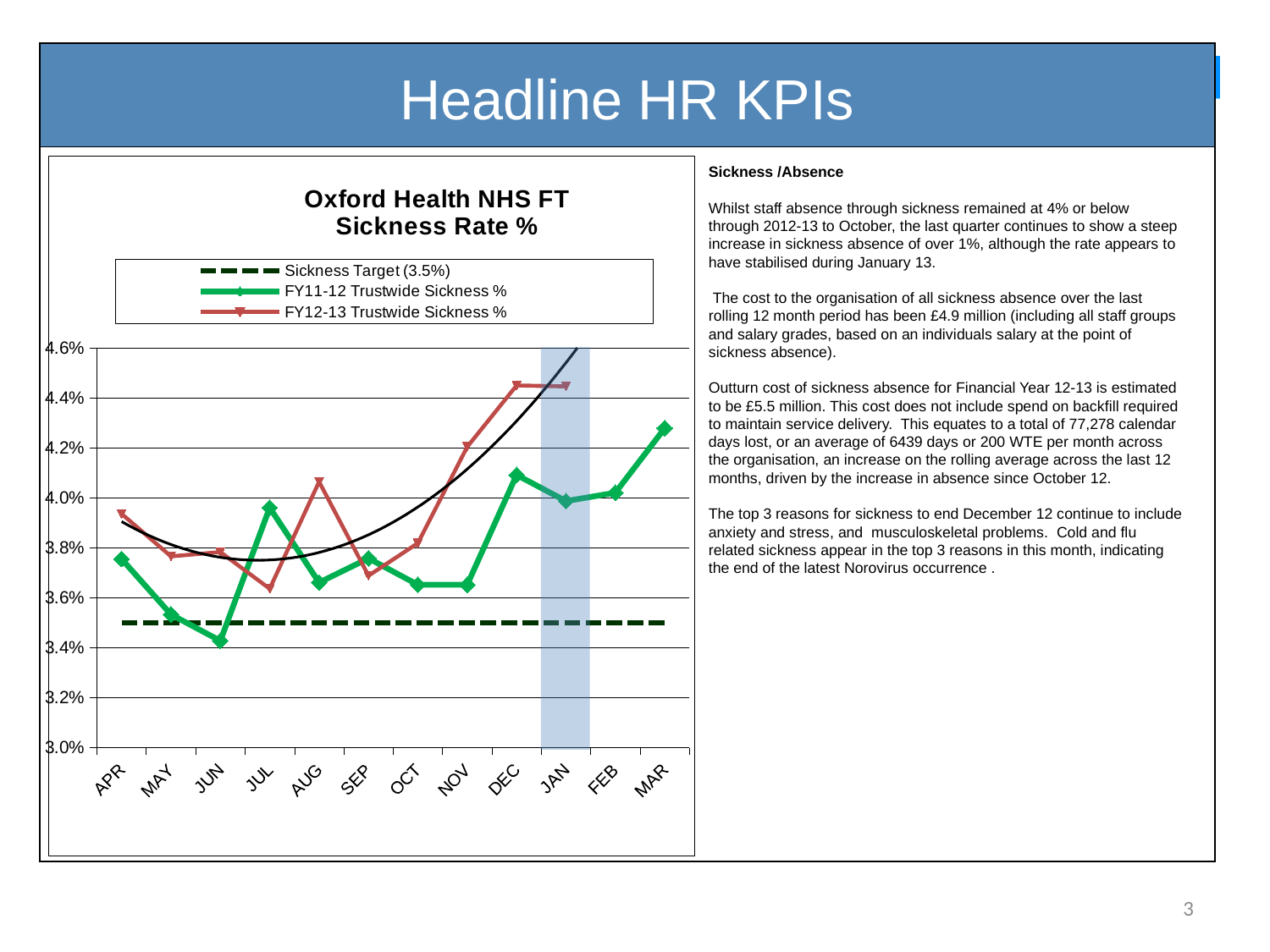
In which month is the FY11-12 Trustwide Sickness % at its lowest? JUN In which month is the FY11-12 Trustwide Sickness % at its highest? MAR In OCT, which series has the higher value: FY11-12 Trustwide Sickness % or FY12-13 Trustwide Sickness %? FY12-13 Trustwide Sickness % How many months are shown along the x axis of the chart? 12 Is the FY11-12 Trustwide Sickness % value for JUN greater or less than 3.6%? less How many series does the chart legend list? 3 Is the FY12-13 Trustwide Sickness % value for JUL greater or less than 3.8%? less Is the FY12-13 Trustwide Sickness % value for DEC greater or less than 4.2%? greater Does the FY12-13 Trustwide Sickness % rise or fall from OCT to DEC? rise What kind of chart is shown on the slide? line chart What is the value of the Sickness Target line shown in the chart? 3.5%